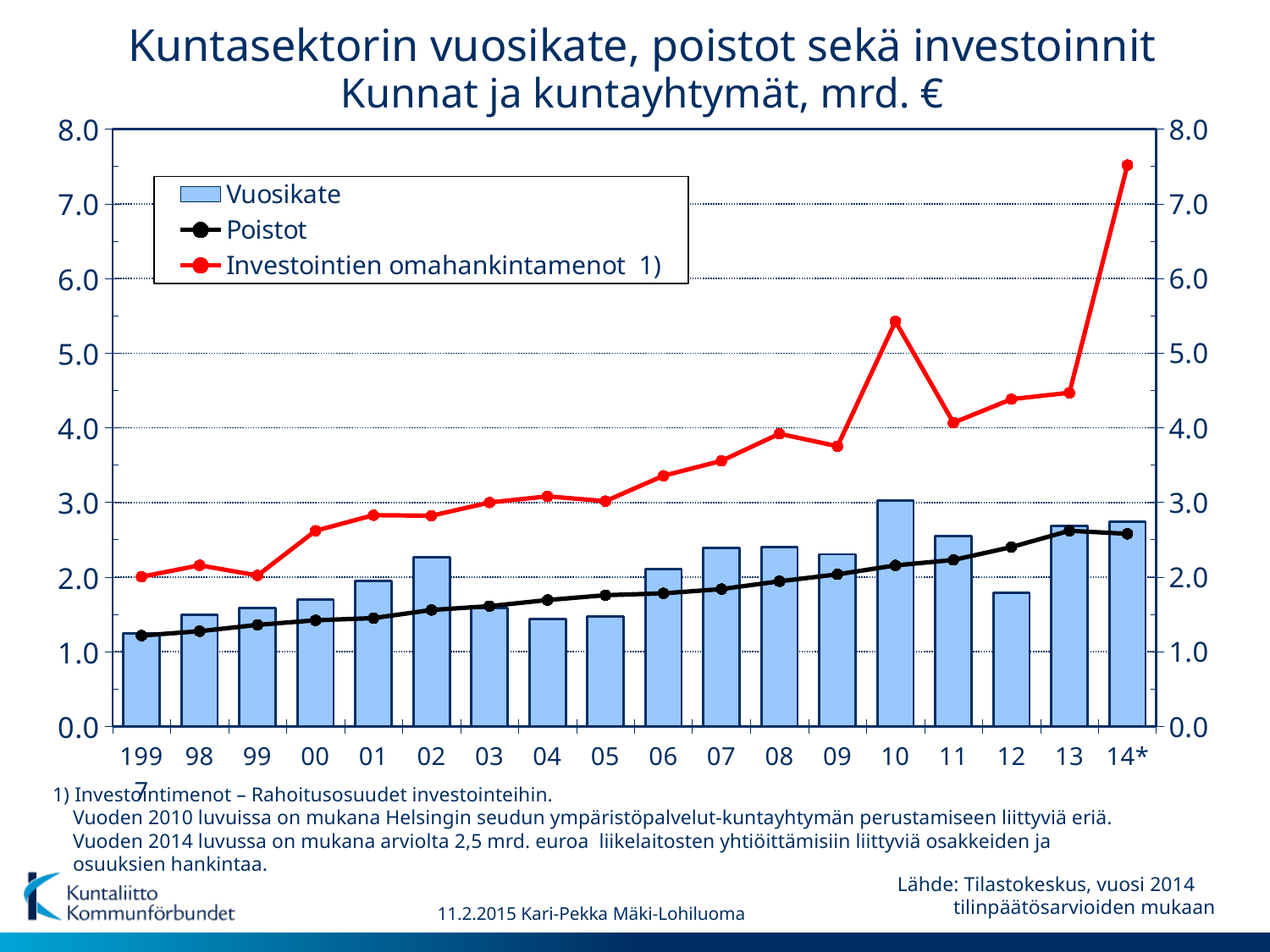
What colour is the Investointien omahankintamenot 1) line? Red Which series is drawn as bars? Vuosikate Does the Poistot line generally rise or fall from 1997 to 14*? Rise How many series does the legend list? 3 Is the Vuosikate value for 04 greater or less than 2.0? less In which year is Investointien omahankintamenot 1) highest? 14* Is the value of Investointien omahankintamenot 1) for 14* greater or less than 7.0? greater In which year is the Vuosikate bar highest? 10 What kind of chart is shown on the slide? A combined bar and line chart Which year has the larger Investointien omahankintamenot 1) value, 10 or 11? 10 How many years are shown on the x axis? 18 Is the value of Investointien omahankintamenot 1) for 10 greater or less than 5.0? greater